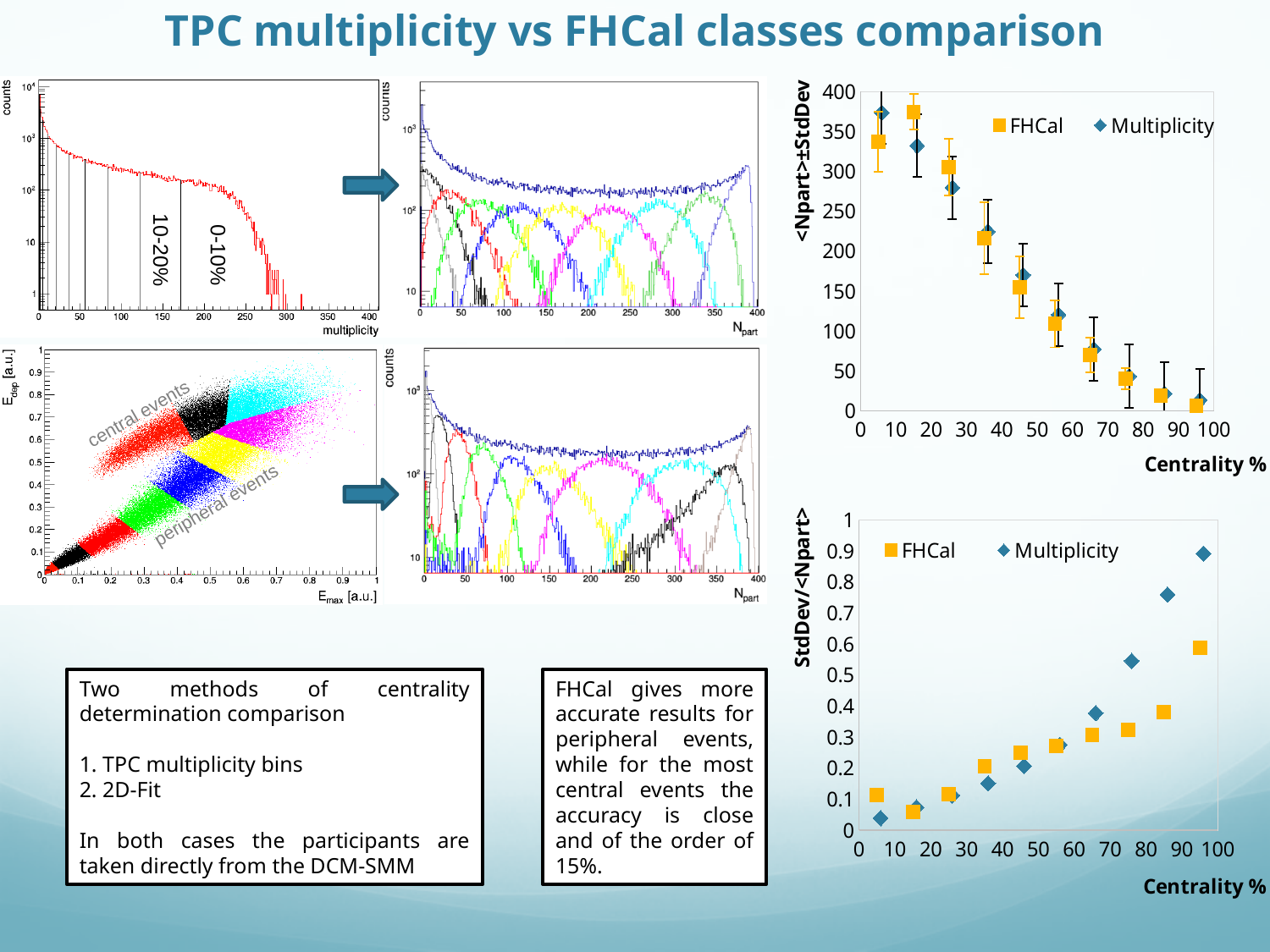
In the top-right chart (<Npart>±StdDev vs Centrality %), how many series does the legend list? 2 In the bottom-right chart (StdDev/<Npart> vs Centrality %), do the values rise or fall as centrality increases? Rise In the bottom-right chart (StdDev/<Npart> vs Centrality %), is the Multiplicity value at the highest centrality point greater or less than 0.8? greater In the top-right chart (<Npart>±StdDev vs Centrality %), how many data points does each series have? 10 In the bottom-right chart (StdDev/<Npart> vs Centrality %), is the FHCal value at the highest centrality point greater or less than 0.7? less In the bottom-right chart (StdDev/<Npart> vs Centrality %), what are the two legend entries? FHCal and Multiplicity In the top-right chart (<Npart>±StdDev vs Centrality %), do the values rise or fall as centrality increases? Fall In the top-right chart (<Npart>±StdDev vs Centrality %), is the FHCal value at the highest centrality point greater or less than 50? less What kind of chart is the bottom-right chart (StdDev/<Npart> vs Centrality %)? Scatter chart In the bottom-right chart (StdDev/<Npart> vs Centrality %), at the highest centrality point, which series has the larger value, FHCal or Multiplicity? Multiplicity What is the x-axis label of the top-right chart (<Npart>±StdDev)? Centrality %